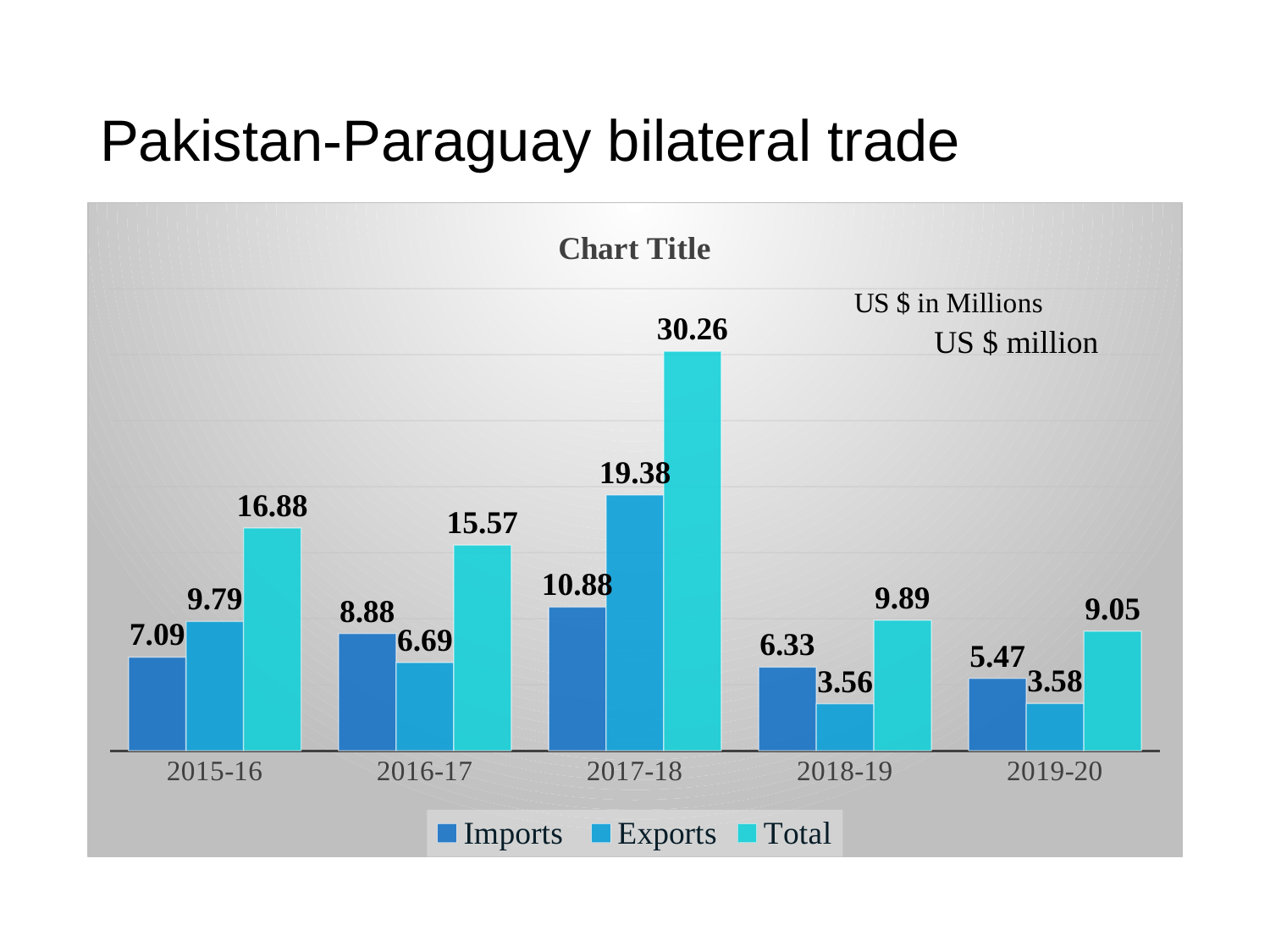
What is the value of Exports for 2016-17? 6.69 Which year has the lowest Exports value? 2018-19 What is the value of Imports for 2017-18? 10.88 What unit is stated for the values in the chart? US $ in Millions What is the difference between Exports and Imports in 2015-16? 2.70 Which year has the highest Total value? 2017-18 What kind of chart is shown on the slide? Bar chart What is the Total value for 2019-20? 9.05 How many years are shown on the x axis? 5 Which is larger in 2016-17, Imports or Exports? Imports Do the Total values rise or fall from 2017-18 to 2019-20? Fall How many series does the legend list? 3